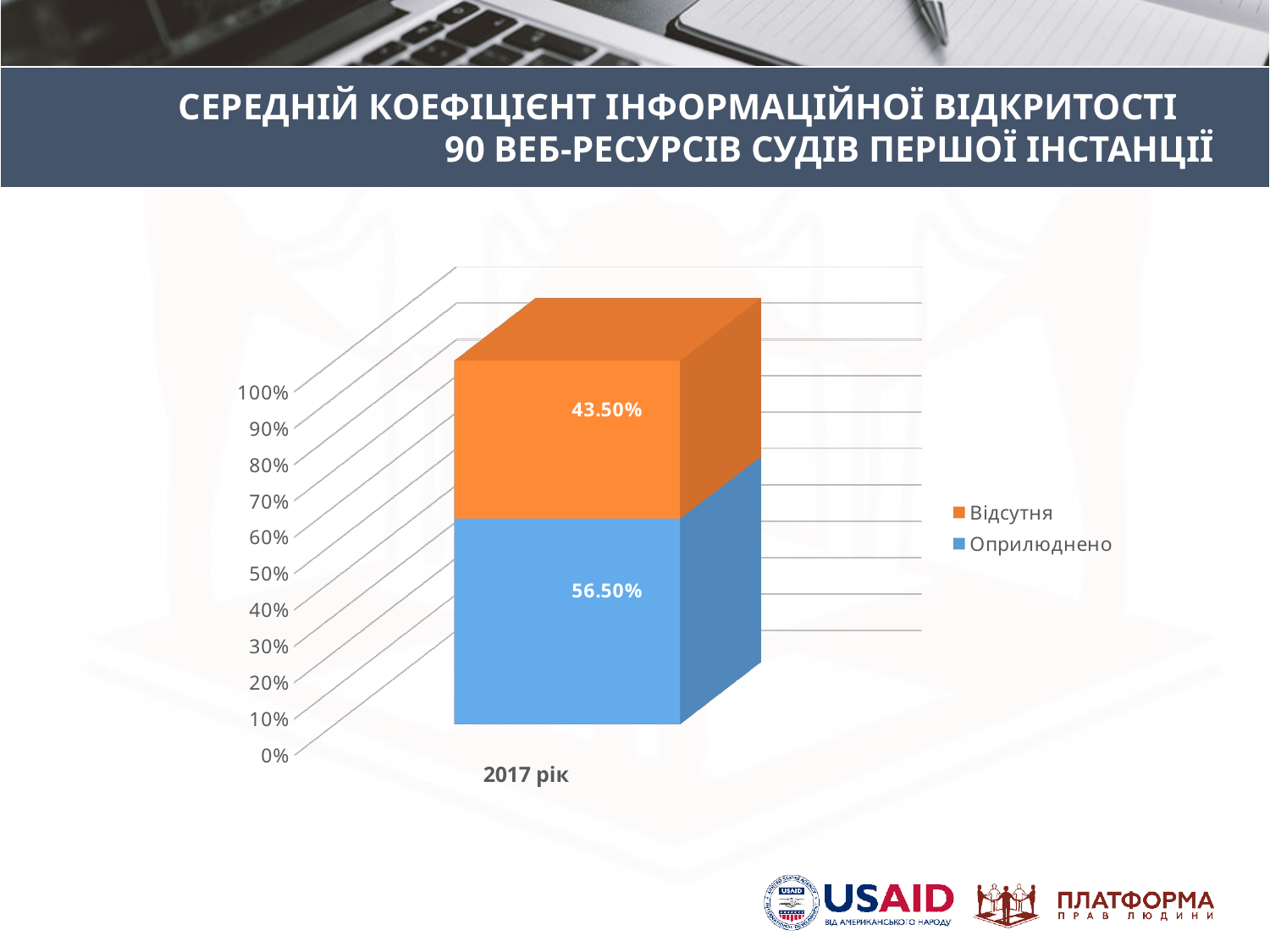
What kind of chart is shown on the slide? Stacked bar chart What is the value for Відсутня in 2017 рік? 43.50% How many categories are shown on the x axis? 1 What is the value for Оприлюднено in 2017 рік? 56.50% Is the value for Відсутня greater or less than 50%? less What is the category label shown on the x axis? 2017 рік How many series does the legend list? 2 What is the difference between the Оприлюднено and Відсутня values in 2017 рік? 13.00% Which colour represents Відсутня in the chart? Orange Which series has the larger value in 2017 рік, Оприлюднено or Відсутня? Оприлюднено Is the value for Оприлюднено greater or less than 50%? greater What is the total of the stacked bar for 2017 рік? 100%